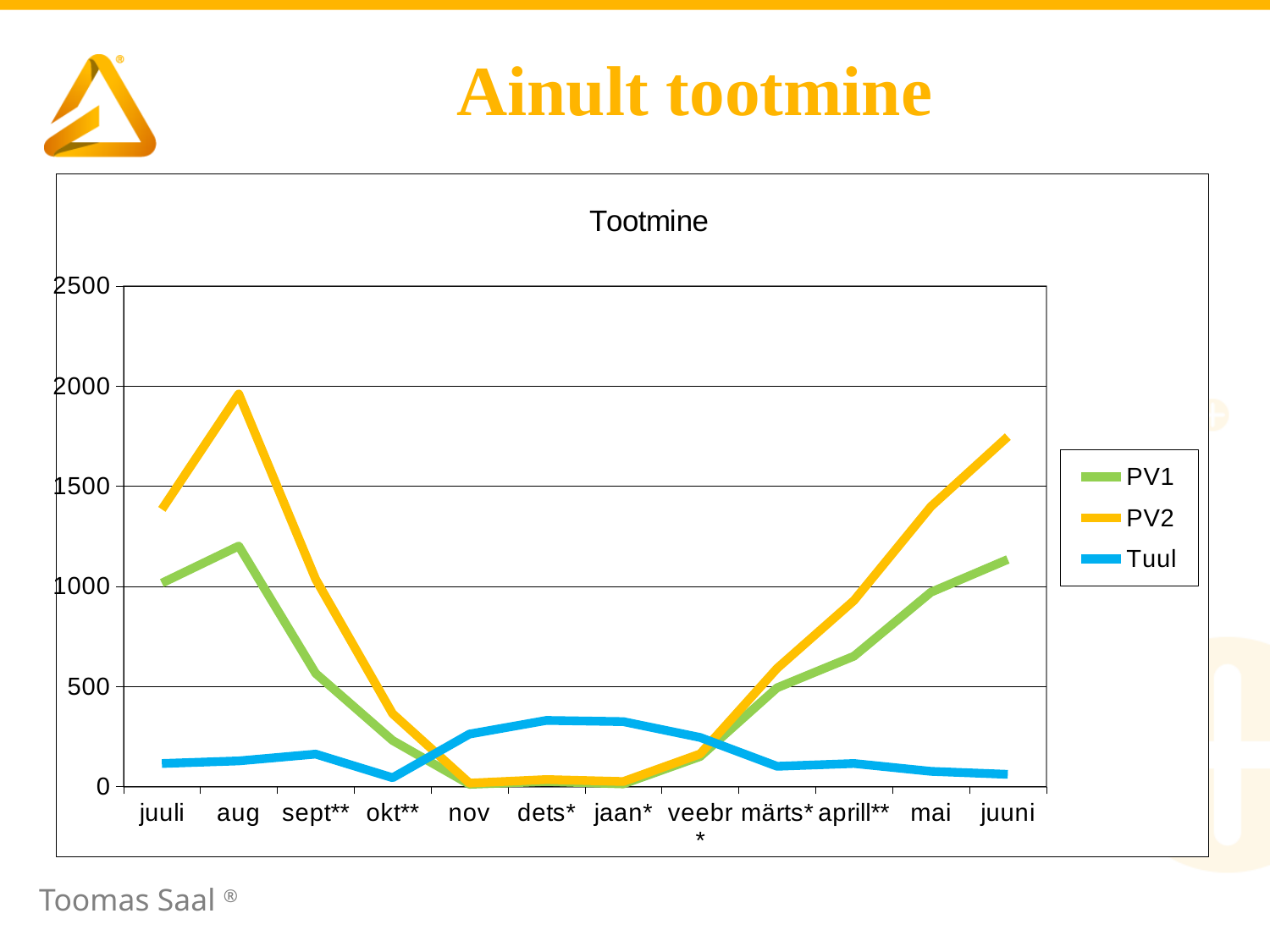
Is the value of PV2 in juuni greater or less than 1500? greater How many months are shown on the x axis of the Tootmine chart? 12 Is the value of PV2 in aug greater or less than 1500? greater In which month does PV2 reach its highest value? aug What kind of chart is shown on the slide? line chart What is the title of the chart? Tootmine Which series is drawn in blue in the Tootmine chart? Tuul Does PV2 rise or fall from aug to nov? fall Is the value of Tuul in dets* greater or less than 500? less In which month does PV1 reach its highest value? aug Which series has the larger value in dets*, PV1 or Tuul? Tuul How many series does the legend of the Tootmine chart list? 3